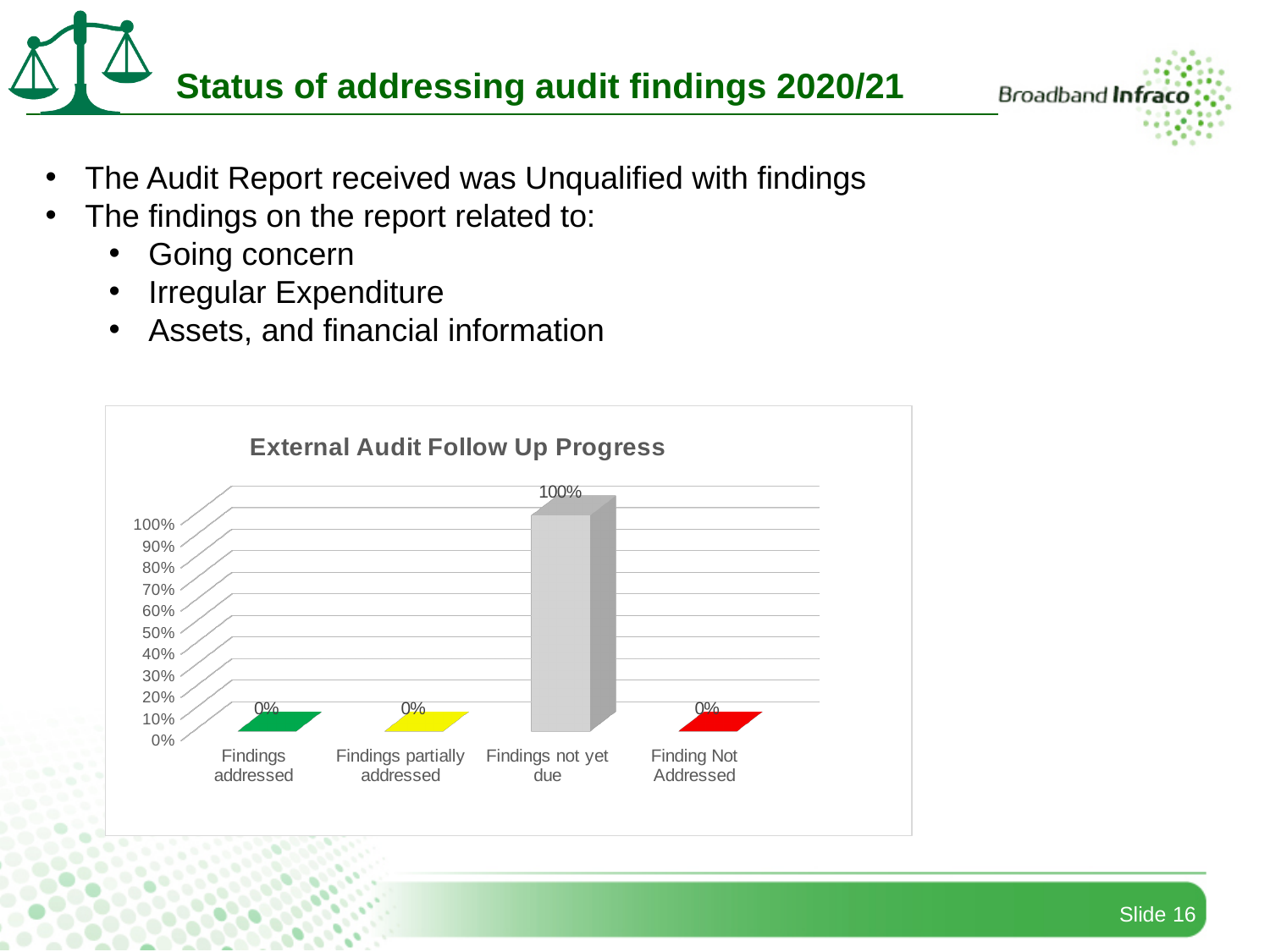
What is the value for Findings addressed? 0% What kind of chart is shown? bar chart Which category has the highest value? Findings not yet due Which is larger, Findings not yet due or Finding Not Addressed? Findings not yet due Is the value for Findings not yet due greater or less than 50%? greater What is the title of the chart? External Audit Follow Up Progress What is the value for Findings partially addressed? 0% What colour is the bar for Finding Not Addressed? red What is the value for Findings not yet due? 100% What is the value for Finding Not Addressed? 0% How many categories are shown on the x axis? 4 What is the difference between Findings not yet due and Findings addressed? 100%